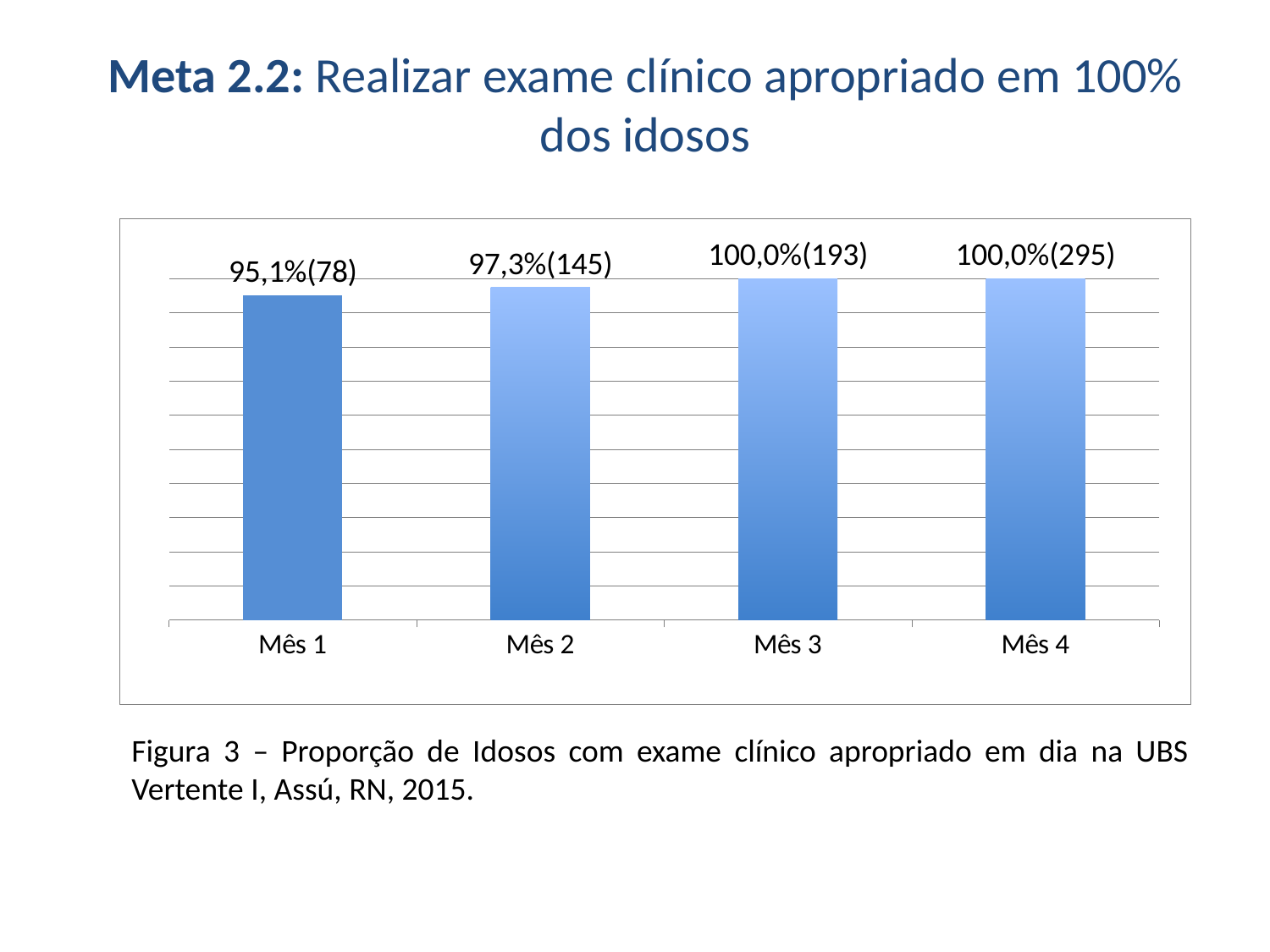
What kind of chart is shown on the slide? Bar chart What is the data label shown for Mês 1? 95,1%(78) What is the difference in percentage points between Mês 2 and Mês 1? 2,2 What is the data label shown for Mês 4? 100,0%(295) Which is larger, the proportion for Mês 1 or for Mês 2? Mês 2 Do the proportions rise or fall from Mês 1 to Mês 4? Rise How many months (categories) are shown on the x axis? 4 What is the data label shown for Mês 3? 100,0%(193) What figure number is given in the caption below the chart? Figura 3 What is the data label shown for Mês 2? 97,3%(145) Which month has the lowest proportion? Mês 1 How many more elderly people are counted in Mês 4 than in Mês 3? 102